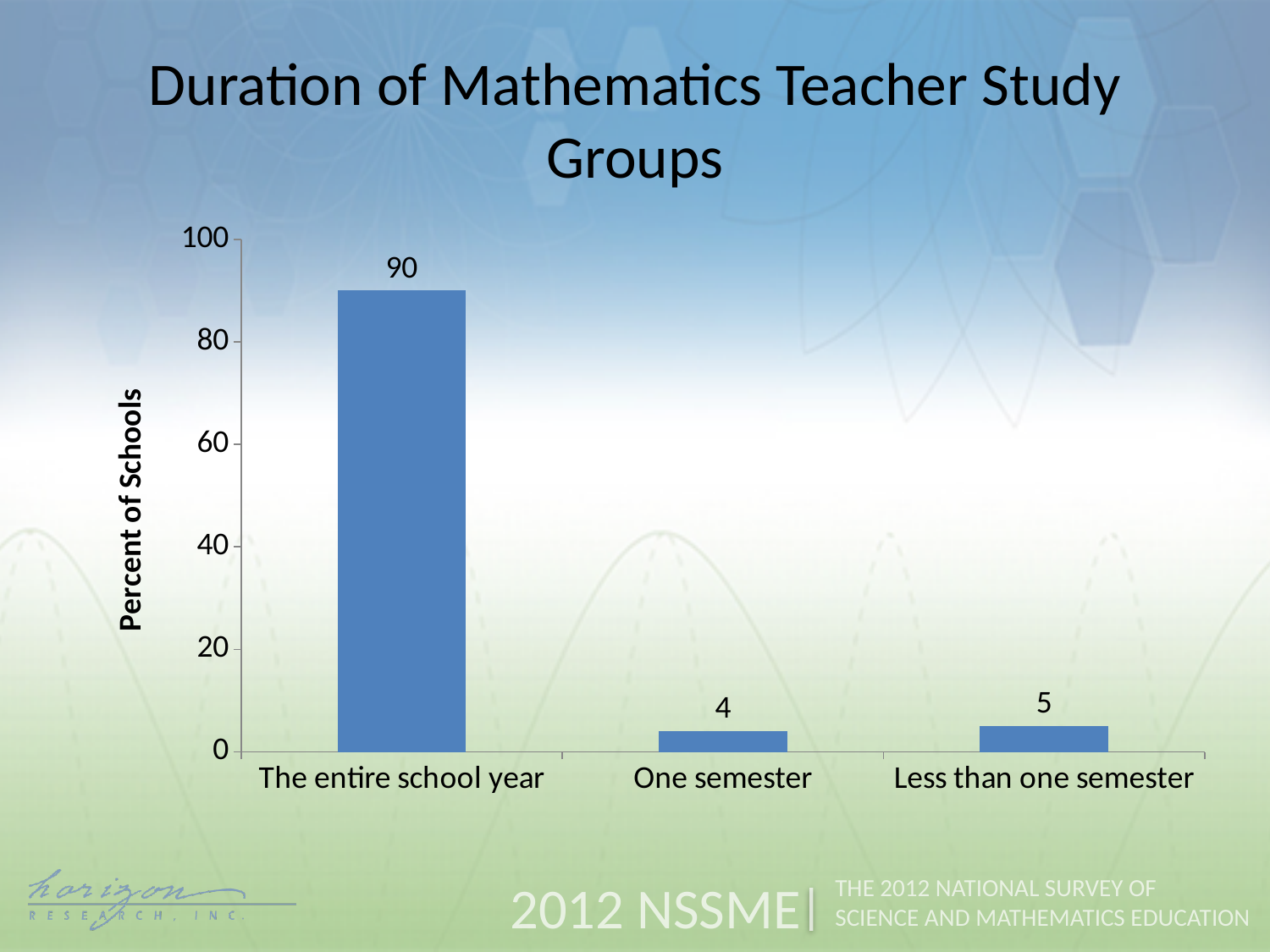
Which is larger: the value for 'The entire school year' or the value for 'One semester'? The entire school year What percent of schools have mathematics teacher study groups lasting the entire school year? 90 Which category has the highest percent of schools? The entire school year What is the value for 'One semester'? 4 What is the difference between the values for 'Less than one semester' and 'One semester'? 1 What is the value for 'Less than one semester'? 5 What kind of chart is shown on the slide? Bar chart Is the value for 'The entire school year' greater or less than 80? greater What is the difference between the values for 'The entire school year' and 'Less than one semester'? 85 How many categories are shown on the x axis? 3 Which category has the lowest percent of schools? One semester What is the label of the vertical axis? Percent of Schools